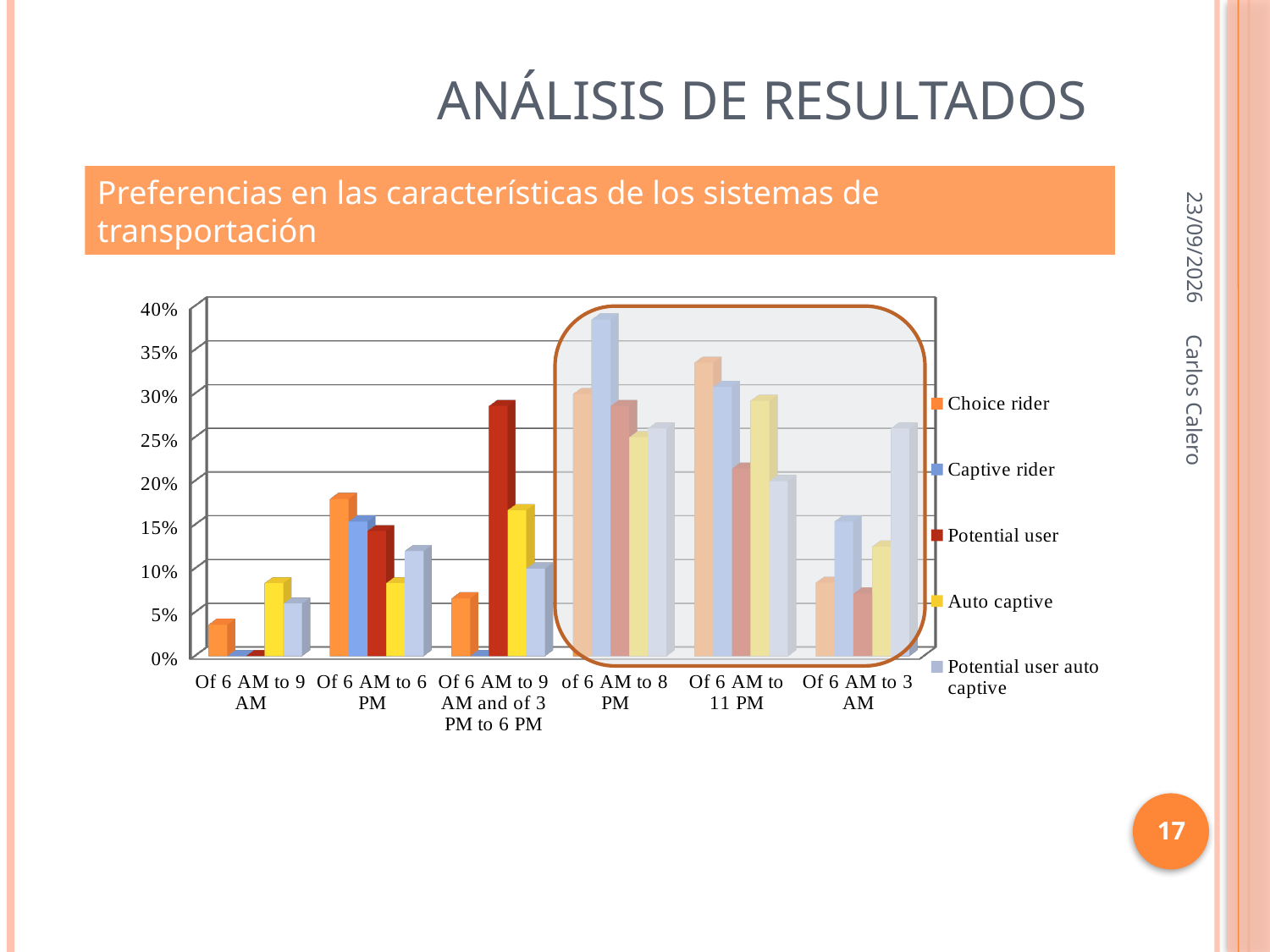
Is the Potential user auto captive value for "Of 6 AM to 3 AM" greater or less than 20%? greater Which category has the highest Captive rider value? of 6 AM to 8 PM How many time-period categories are shown on the x axis of the chart? 6 Which category on the chart is highlighted with a rounded outline? of 6 AM to 8 PM, Of 6 AM to 11 PM and Of 6 AM to 3 AM Is the Captive rider value for "of 6 AM to 8 PM" greater or less than 35%? greater In the "Of 6 AM to 11 PM" category, which is larger: Choice rider or Potential user? Choice rider Is the Auto captive value for "Of 6 AM to 9 AM" greater or less than 10%? less In the "Of 6 AM to 3 AM" category, which is larger: Choice rider or Captive rider? Captive rider How many series does the chart legend list? 5 What kind of chart is shown on the slide? bar chart